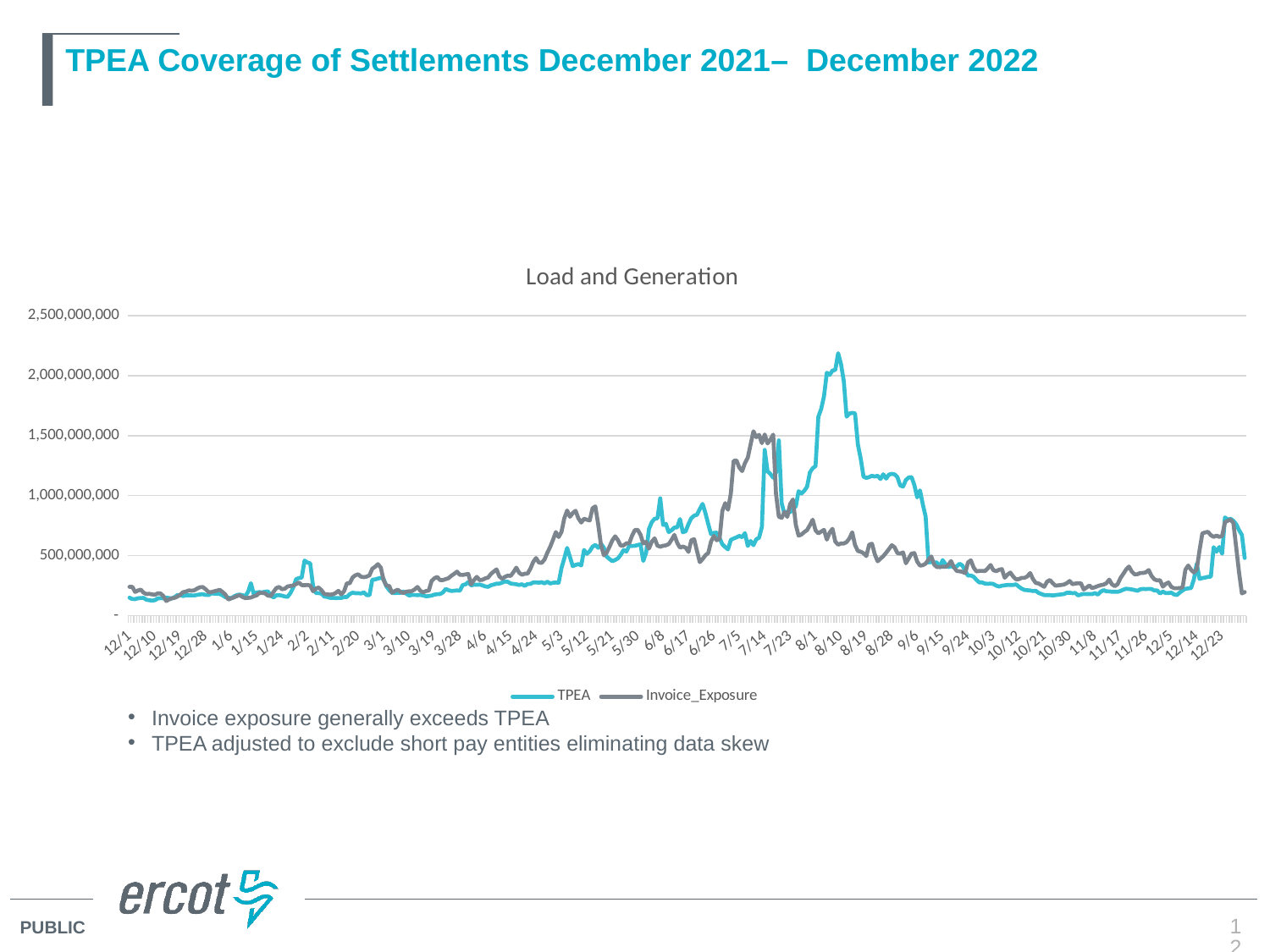
Is the value of Invoice_Exposure at 12/1 greater or less than 500,000,000? less What kind of chart is shown on the slide? Line chart Which series reaches the highest peak on the chart? TPEA Is the value of Invoice_Exposure around 5/3 greater or less than 500,000,000? greater Does the TPEA line generally rise or fall between 8/10 and 10/3? fall Is the peak value of TPEA around 8/10 greater or less than 2,000,000,000? greater What is the title of the chart? Load and Generation How many series does the chart legend list? 2 Around 8/10, which series has the larger value, TPEA or Invoice_Exposure? TPEA Which two series are listed in the chart legend? TPEA and Invoice_Exposure Around 7/5, which series has the larger value, TPEA or Invoice_Exposure? Invoice_Exposure